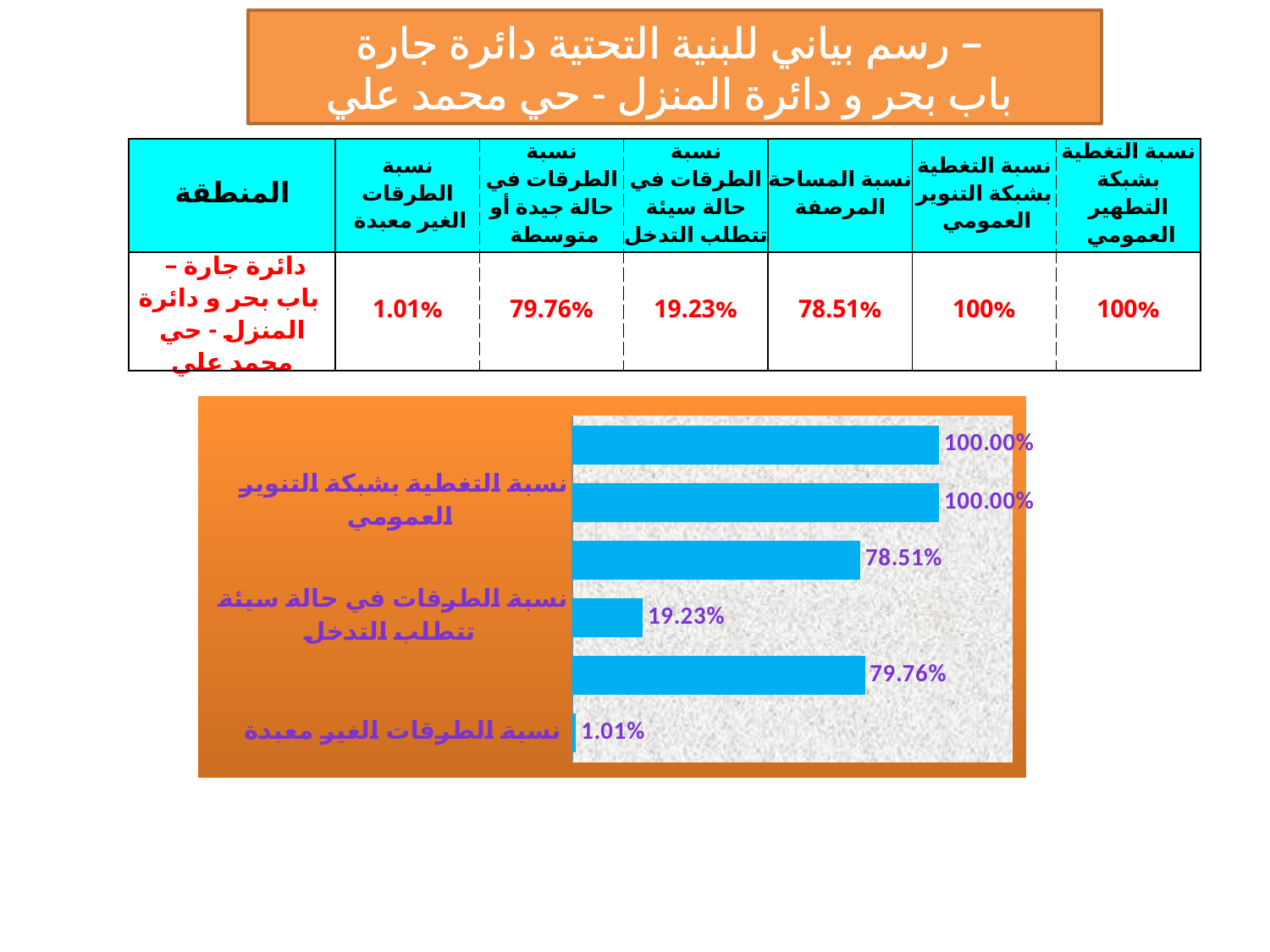
How many bars in the chart are labelled 100.00%? 2 What colour are the bars in the chart? blue Which is larger: the value for نسبة الطرقات في حالة سيئة تتطلب التدخل or the value for نسبة الطرقات الغير معبدة? نسبة الطرقات في حالة سيئة تتطلب التدخل What is the value shown for نسبة الطرقات الغير معبدة? 1.01% Which category has the lowest value in the chart? نسبة الطرقات الغير معبدة What is the value shown for نسبة التغطية بشبكة التنوير العمومي? 100.00% How many bars does the chart contain? 6 What is the highest value labelled on the chart? 100.00% What is the value shown for نسبة الطرقات في حالة سيئة تتطلب التدخل? 19.23% What is the difference between the value for نسبة الطرقات في حالة سيئة تتطلب التدخل and the value for نسبة الطرقات الغير معبدة? 18.22% What is the difference between the value for نسبة التغطية بشبكة التنوير العمومي and the value for نسبة الطرقات في حالة سيئة تتطلب التدخل? 80.77% What kind of chart is shown on the slide? bar chart